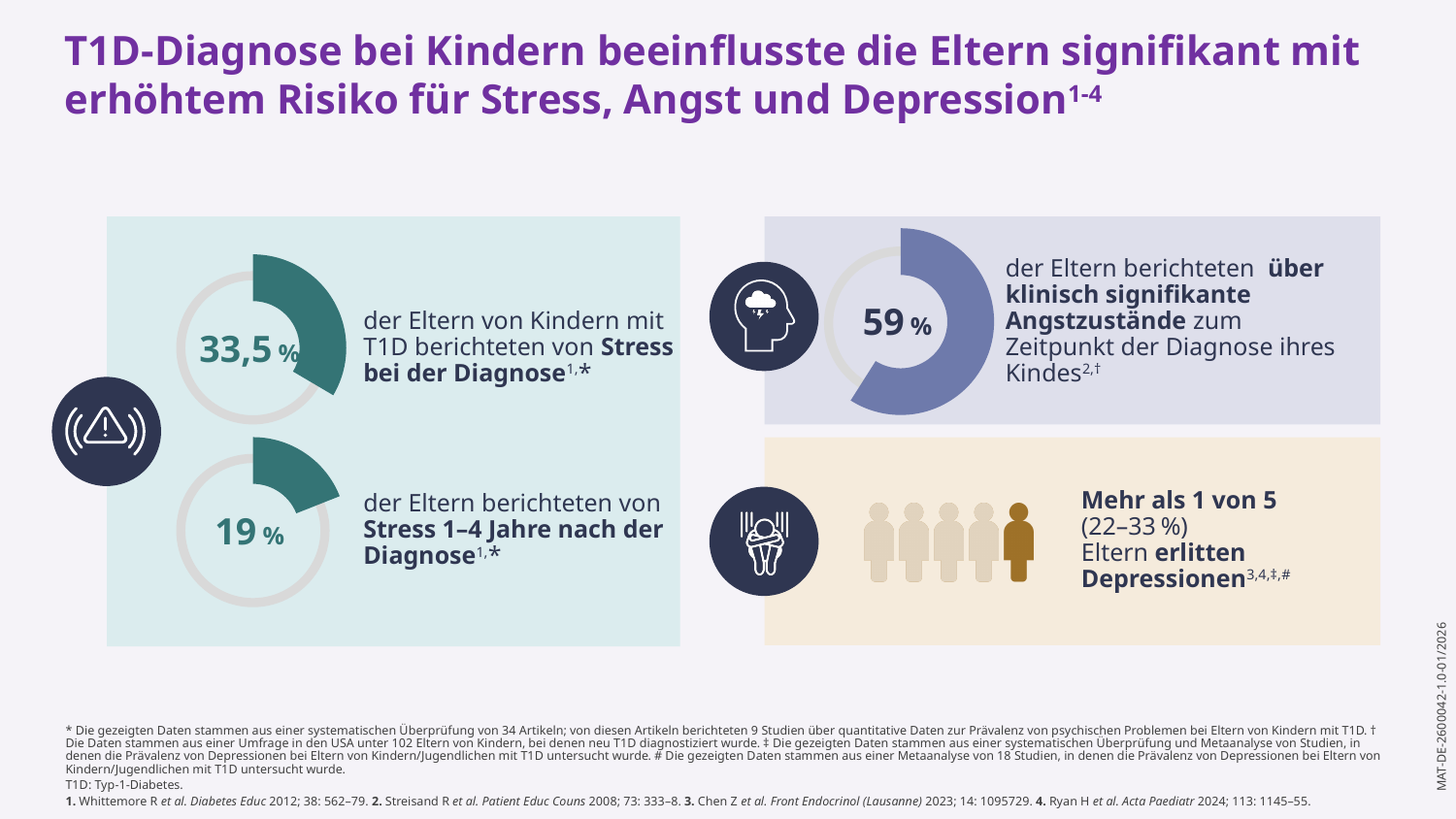
What is the difference in percentage points between parents reporting stress at diagnosis (top-left chart) and parents reporting stress 1–4 years after diagnosis (bottom-left chart)? 14,5 percentage points What is the difference in percentage points between the anxiety value (59 %) and the stress-at-diagnosis value (33,5 %)? 25,5 percentage points Of the three donut charts on the slide, which shows the lowest percentage? Stress 1–4 years after diagnosis (19 %) Which is larger: the share of parents reporting stress at diagnosis or the share reporting stress 1–4 years after diagnosis? Stress at diagnosis (33,5 %) In the top-left donut chart, what percentage of parents of children with T1D reported stress at the time of diagnosis? 33,5 % Of the three donut charts on the slide, which shows the highest percentage? Clinically significant anxiety at diagnosis (59 %) According to the bottom-right pictogram, what percentage range of parents experienced depression? 22–33 % In the top-right donut chart, what percentage of parents reported clinically significant anxiety at the time of their child's diagnosis? 59 % What kind of chart is used to show the 33,5 %, 19 % and 59 % values? Donut chart How many donut charts are shown on the slide? 3 In the bottom-left donut chart, what percentage of parents reported stress 1–4 years after the diagnosis? 19 % In the bottom-right pictogram, how many person icons are shown and how many are highlighted? 5 icons, 1 highlighted